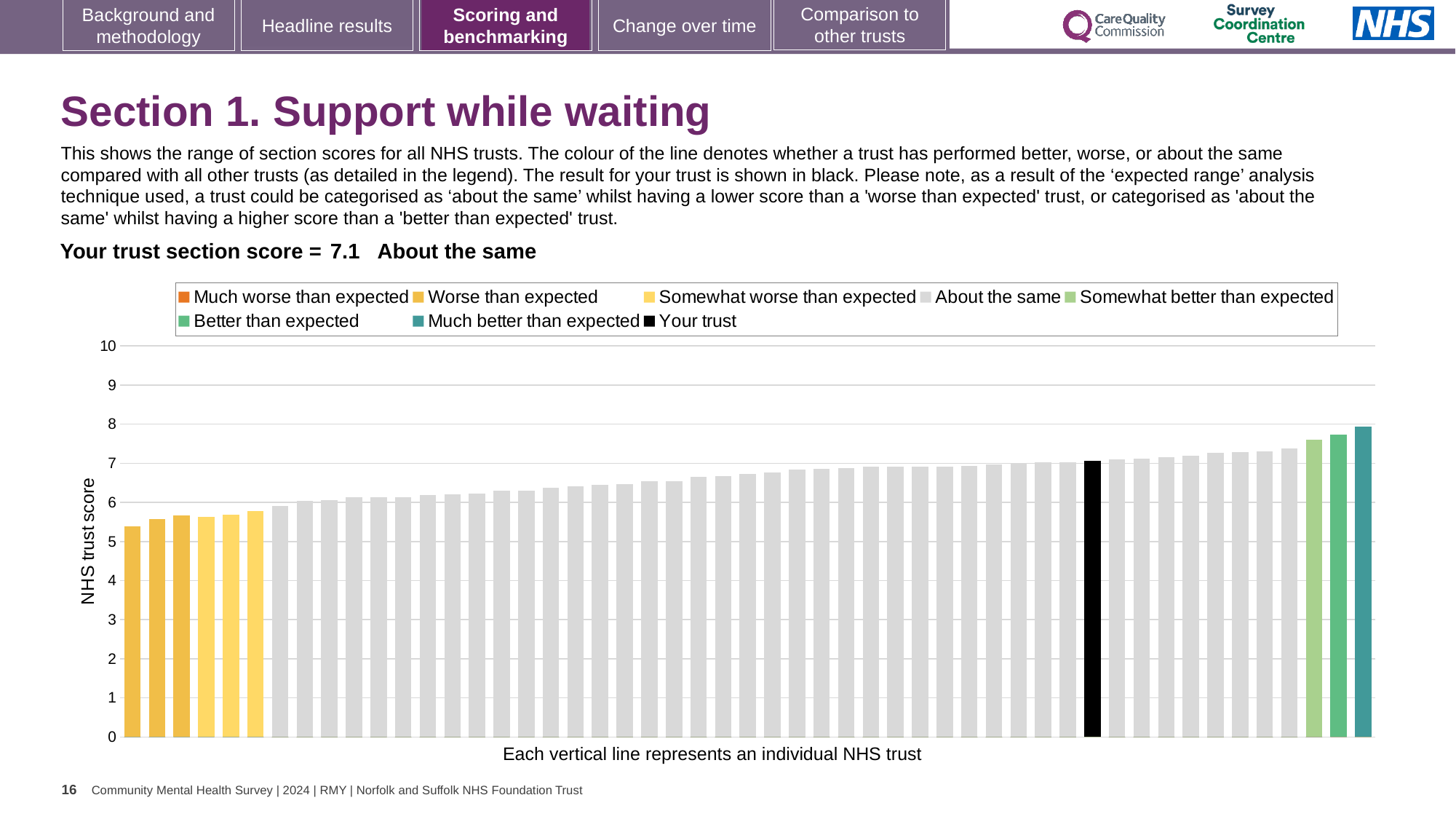
How many bars are coloured as 'Worse than expected' (dark yellow)? 3 Is the value of the tallest bar in the chart greater or less than 7? greater What kind of chart is shown on the slide? Bar chart Is the value of the lowest bar in the chart greater or less than 6? less Which legend category does the tallest bar on the chart belong to? Much better than expected How many entries does the chart legend list? 8 Is the value for your trust's bar greater or less than 6? greater What colour is the bar representing your trust? Black What is the label on the vertical axis of the chart? NHS trust score Which performance category is your trust placed in for this section? About the same What is the section score for your trust shown on the slide? 7.1 Do the bar values rise or fall from left to right along the x axis? Rise